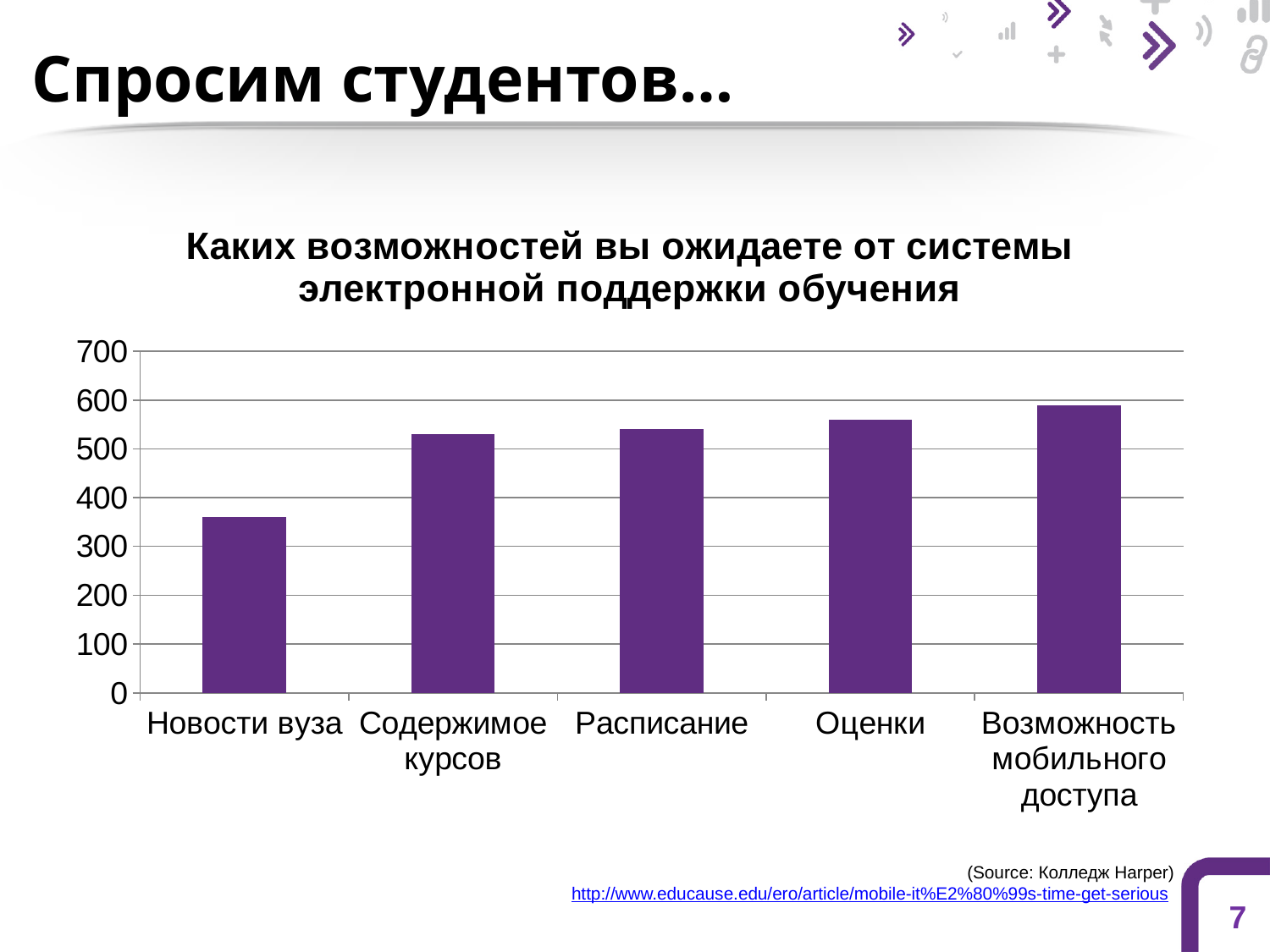
Which is larger, the value for Новости вуза or the value for Оценки? Оценки What kind of chart is shown on the slide? bar chart Which category has the lowest bar in the chart? Новости вуза Which category has the highest bar in the chart? Возможность мобильного доступа What is the title of the chart? Каких возможностей вы ожидаете от системы электронной поддержки обучения Is the value for Возможность мобильного доступа greater or less than 600? less Is the value for Содержимое курсов greater or less than 500? greater Is the value for Оценки greater or less than 500? greater How many categories are shown on the x axis of the chart? 5 Do the bar values rise or fall from left to right along the x axis? rise